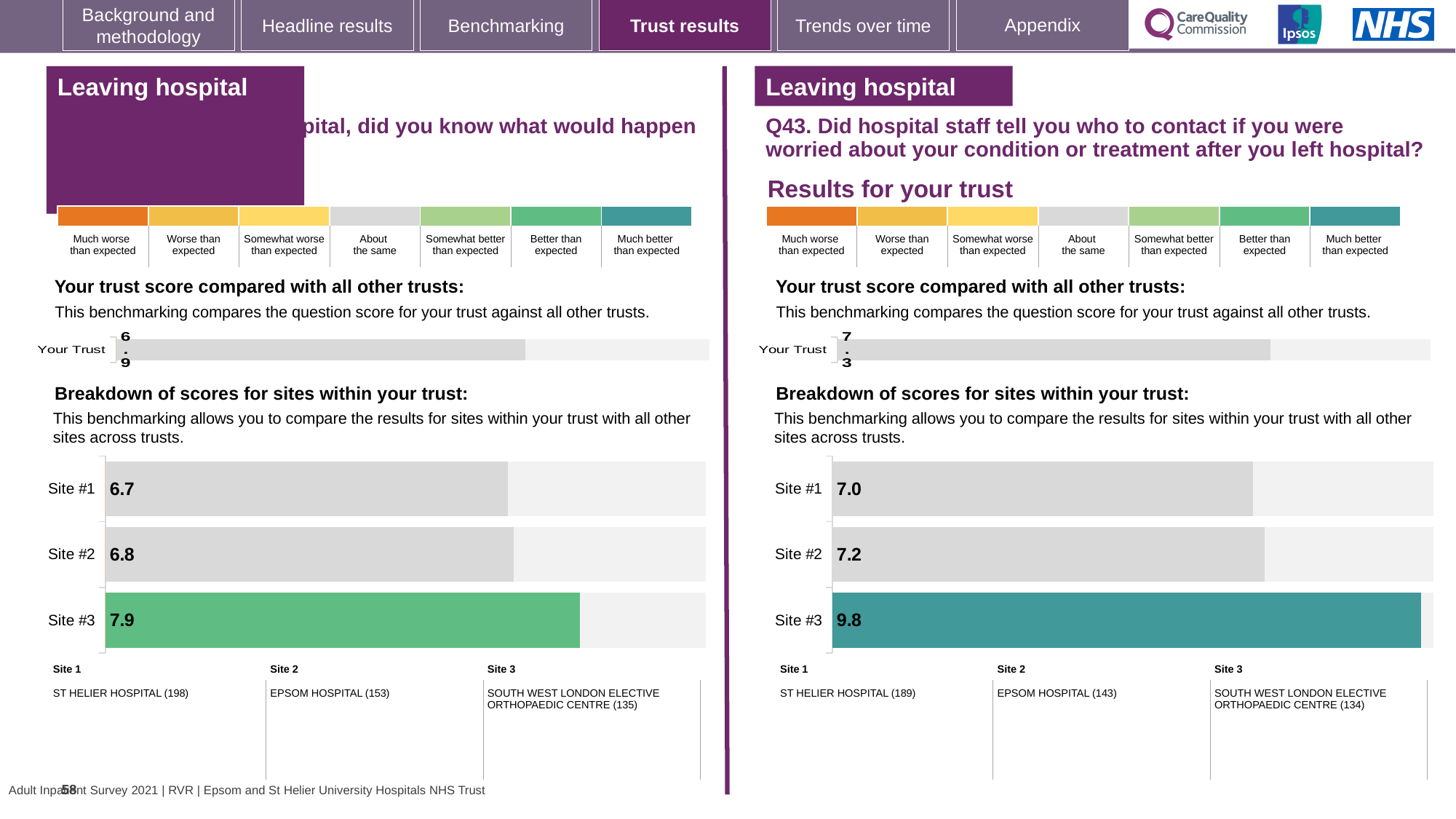
In the Q43 site breakdown chart on the right, what is the difference between the scores for Site #3 and Site #2? 2.6 In the Q43 site breakdown chart on the right, which site has the lowest score? Site #1 In the Q43 site breakdown chart on the right, what is the score for Site #3? 9.8 In the Q43 site breakdown chart on the right, what is the score for Site #1? 7.0 In the site breakdown chart on the left-hand side of the slide, which site has the highest score? Site #3 How many sites are shown in the Q43 site breakdown chart on the right? 3 In the site breakdown chart on the left-hand side of the slide, what is the score for Site #2? 6.8 In the site breakdown chart on the left-hand side of the slide, what is the difference between the scores for Site #3 and Site #1? 1.2 In the site breakdown chart on the left-hand side of the slide, which is larger, the score for Site #1 or Site #2? Site #2 What is the 'Your Trust' score shown in the Q43 trust comparison chart on the right? 7.3 What is the 'Your Trust' score shown in the trust comparison chart on the left-hand side of the slide? 6.9 What kind of chart is used for the Q43 site breakdown on the right? Bar chart